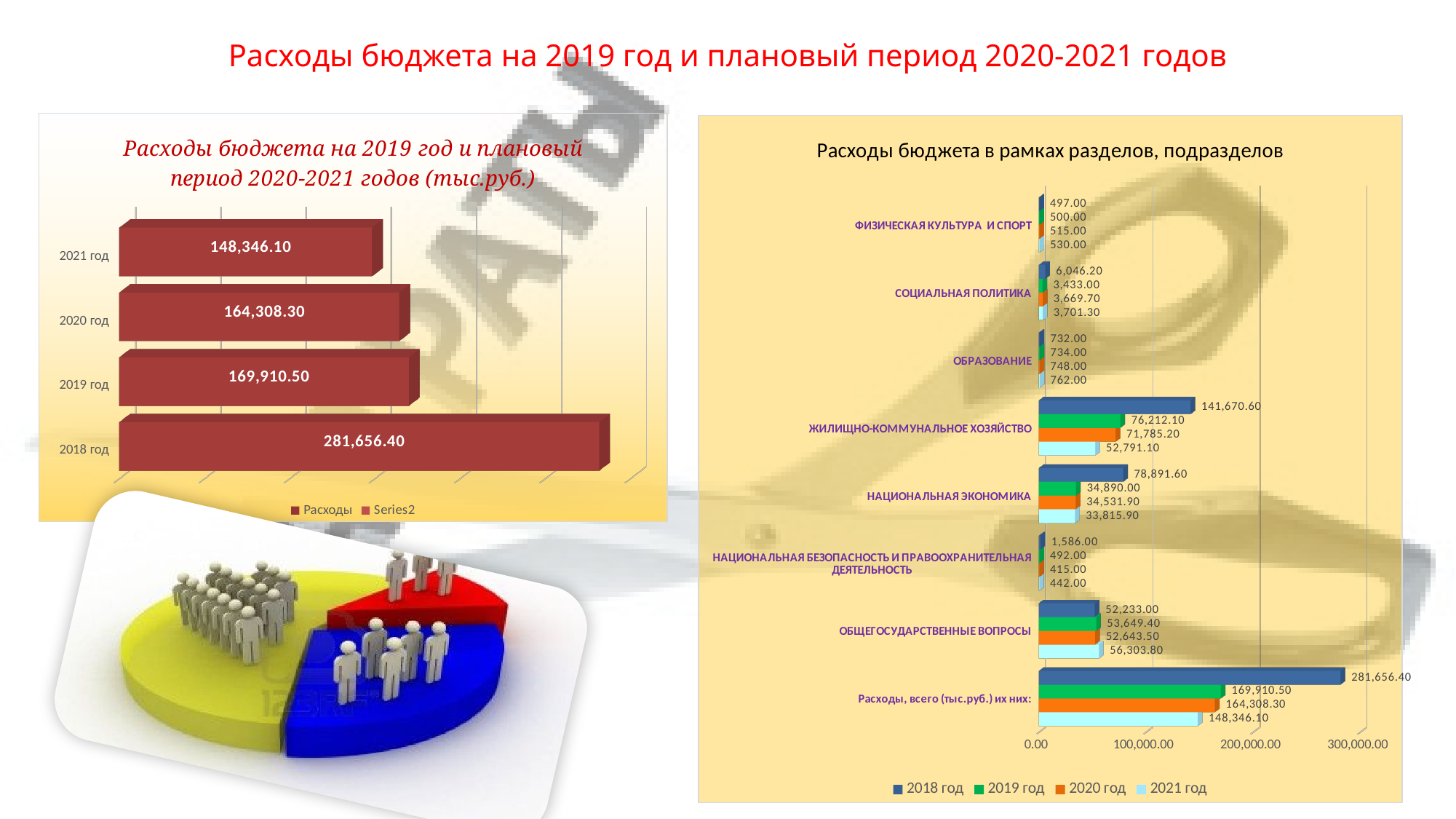
In the left chart titled 'Расходы бюджета на 2019 год и плановый период 2020-2021 годов (тыс.руб.)', which year has the highest value? 2018 год In the right chart titled 'Расходы бюджета в рамках разделов, подразделов', how many series does the legend list? 4 In the left chart titled 'Расходы бюджета на 2019 год и плановый период 2020-2021 годов (тыс.руб.)', which year has the lowest value? 2021 год In the right chart titled 'Расходы бюджета в рамках разделов, подразделов', what is the difference between the 2019 год and 2020 год values for ОБЩЕГОСУДАРСТВЕННЫЕ ВОПРОСЫ? 1,005.90 In the left chart titled 'Расходы бюджета на 2019 год и плановый период 2020-2021 годов (тыс.руб.)', how many years are shown? 4 In the right chart titled 'Расходы бюджета в рамках разделов, подразделов', which is larger for НАЦИОНАЛЬНАЯ ЭКОНОМИКА: the 2019 год value or the 2020 год value? 2019 год In the right chart titled 'Расходы бюджета в рамках разделов, подразделов', what is the 2018 год value for ЖИЛИЩНО-КОММУНАЛЬНОЕ ХОЗЯЙСТВО? 141,670.60 In the left chart titled 'Расходы бюджета на 2019 год и плановый период 2020-2021 годов (тыс.руб.)', what is the value for 2019 год? 169,910.50 In the left chart titled 'Расходы бюджета на 2019 год и плановый период 2020-2021 годов (тыс.руб.)', what is the difference between the values for 2018 год and 2019 год? 111,745.90 In the right chart titled 'Расходы бюджета в рамках разделов, подразделов', what is the 2021 год value for СОЦИАЛЬНАЯ ПОЛИТИКА? 3,701.30 In the right chart titled 'Расходы бюджета в рамках разделов, подразделов', which colour represents 2020 год in the legend? Orange What kind of chart is the left chart titled 'Расходы бюджета на 2019 год и плановый период 2020-2021 годов (тыс.руб.)'? Bar chart